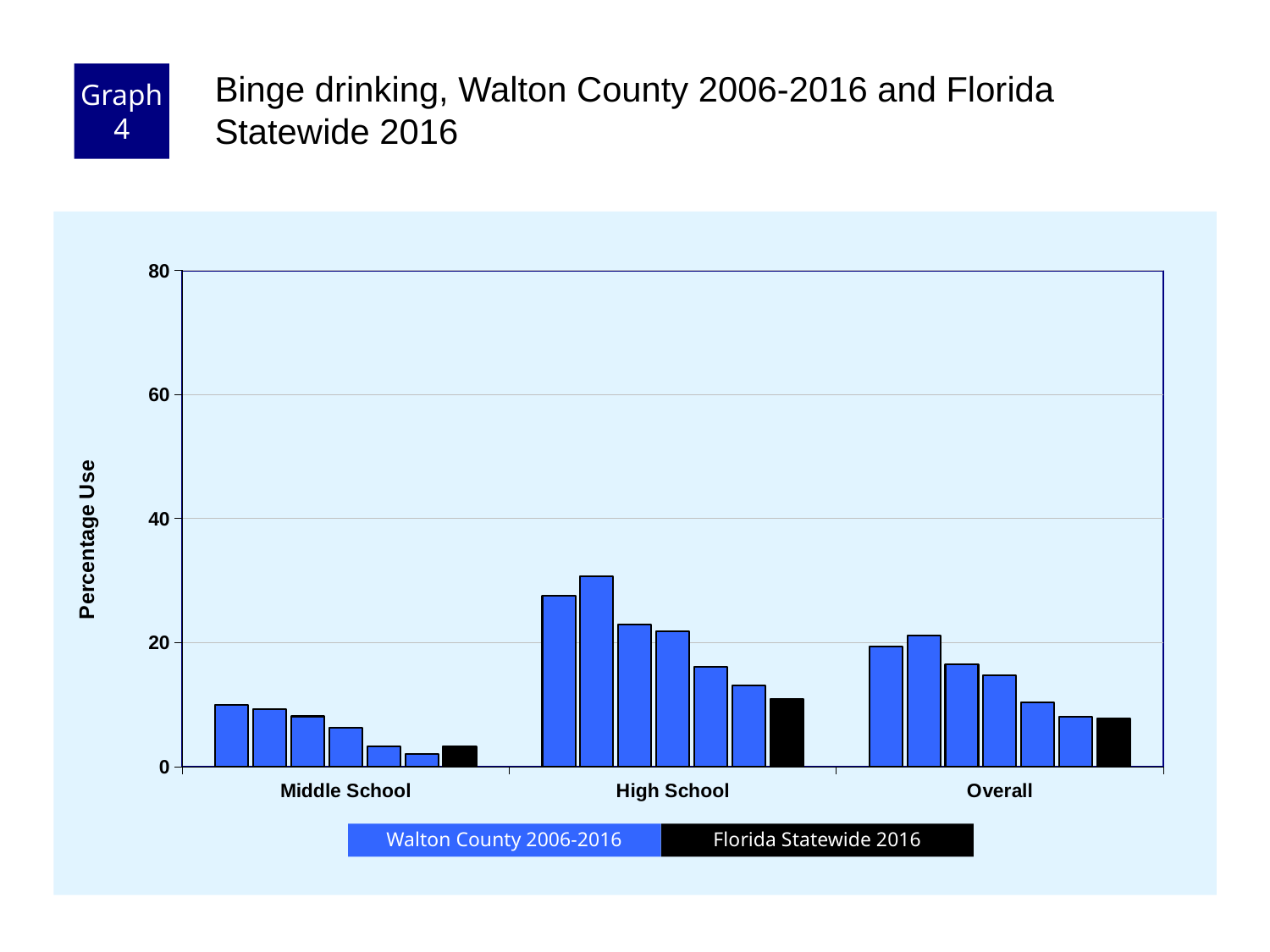
How many category groups are shown on the x axis? 3 Which series is shown in black? Florida Statewide 2016 What kind of chart is shown on the slide? Bar chart Which is larger, the Florida Statewide 2016 value for High School or for Middle School? High School Do the Walton County bars in the Middle School group rise or fall from left to right? fall Is the tallest Walton County bar in the Middle School group greater or less than 20? less Is the Florida Statewide 2016 value for High School greater or less than 20? less Is the tallest Walton County bar in the High School group greater or less than 20? greater Which category group has the highest bars overall? High School How many series does the legend list? 2 What is the label on the y axis? Percentage Use